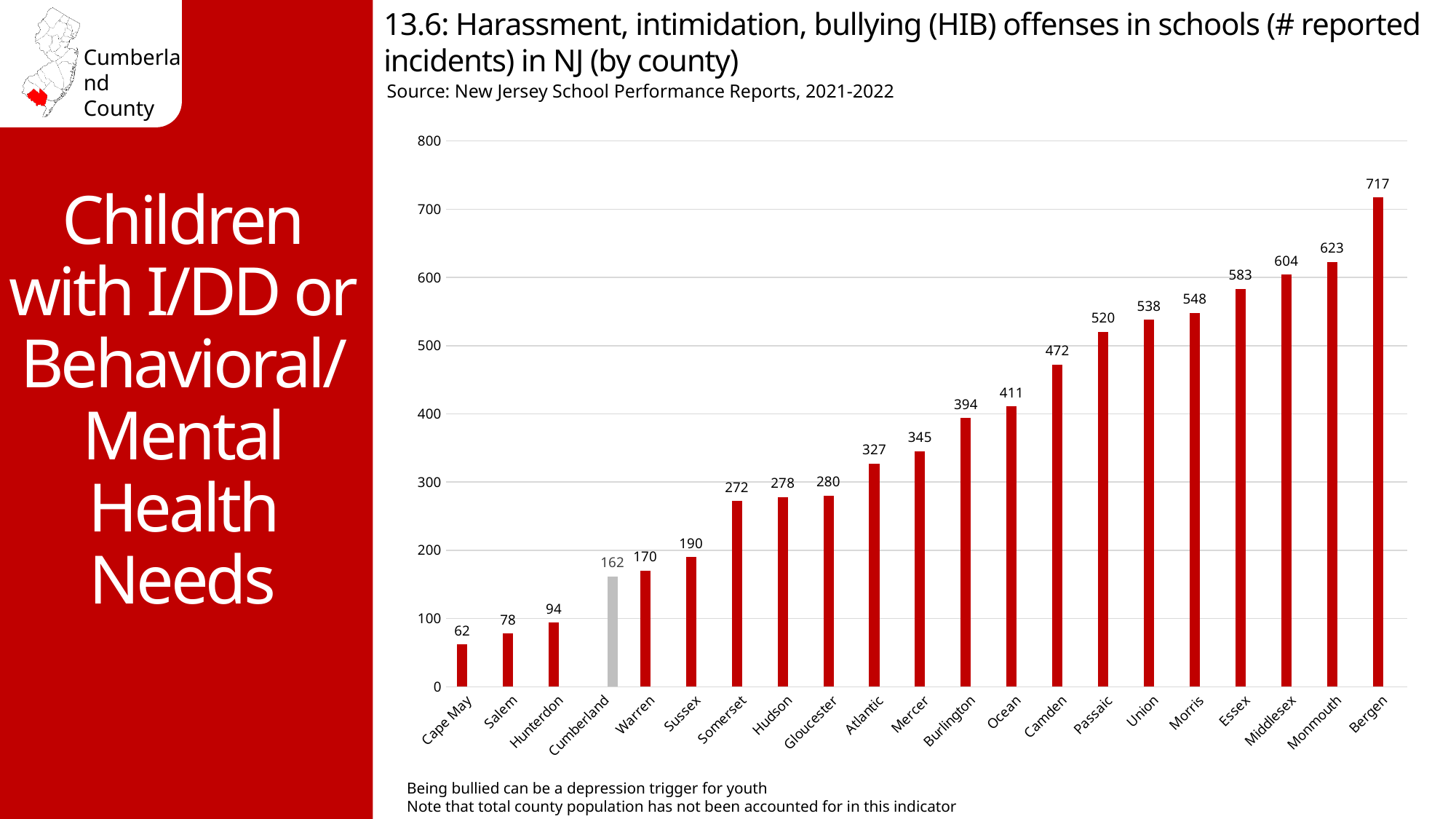
What kind of chart is this? Bar chart How many reported HIB incidents are shown for Cumberland? 162 Which county's bar is shown in gray instead of red? Cumberland What is the value for Gloucester? 280 Which county has the highest number of reported HIB incidents? Bergen Which county has the lowest number of reported HIB incidents? Cape May How many counties are shown on the chart? 21 What is the difference between the values for Bergen and Cape May? 655 Which has a higher value, Camden or Mercer? Camden What is the value for Bergen? 717 What is the difference between the values for Warren and Cumberland? 8 Is the value for Passaic greater or less than 500? greater